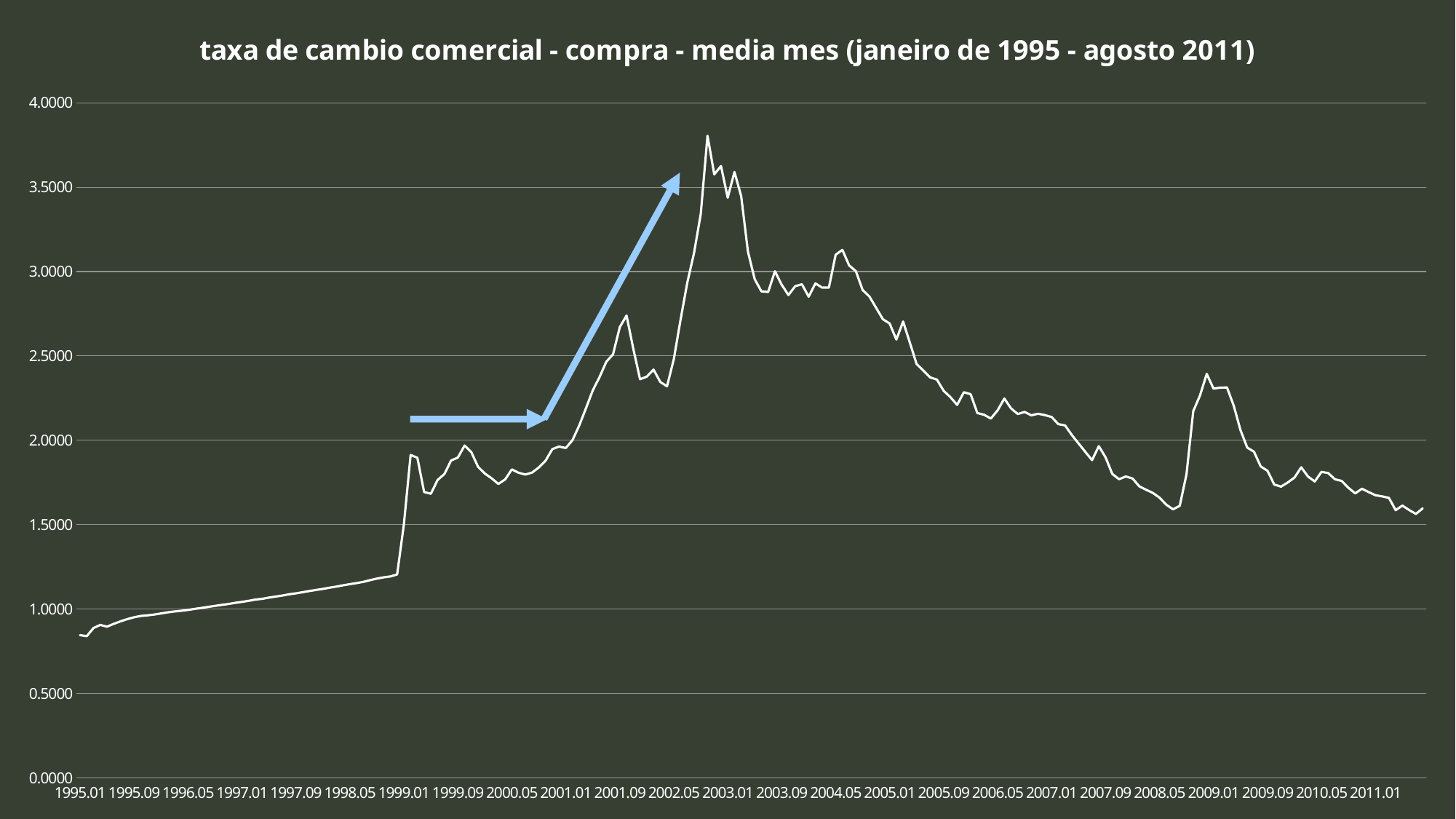
In which year does the line reach its highest value? 2002 Is the value at 2008.05 greater or less than 2.0000? less Is the value at 2011.01 greater or less than 2.0000? less Does the line generally rise or fall between 1995.01 and 1999.01? rise What is the title of the chart? taxa de cambio comercial - compra - media mes (janeiro de 1995 - agosto 2011) What colour are the two arrows drawn over the chart? light blue Is the value at 2005.01 greater or less than 2.5000? greater What kind of chart is shown on the slide? line chart